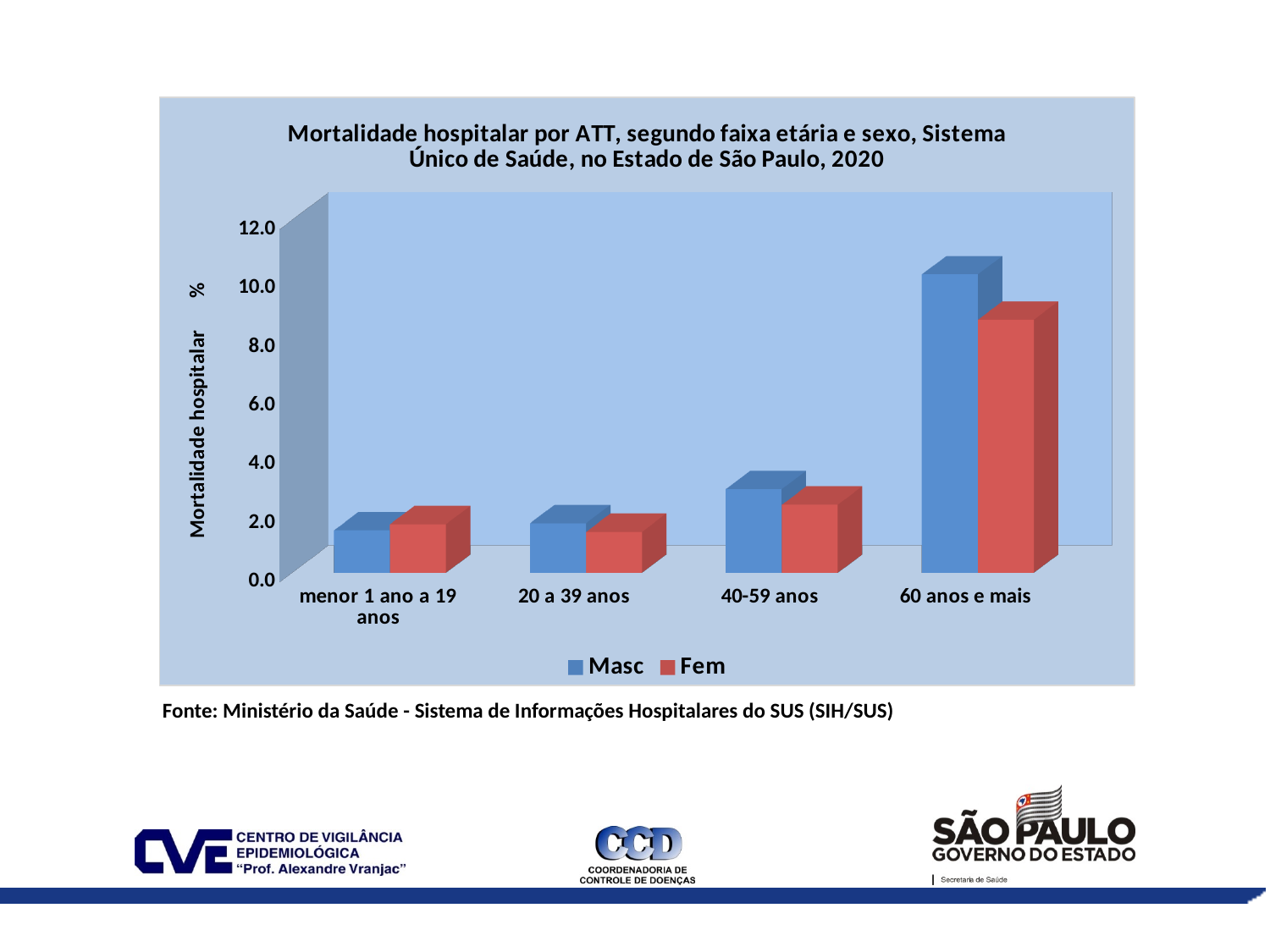
For the 60 anos e mais group, which series has the larger value, Masc or Fem? Masc Is the Fem value for 60 anos e mais greater or less than 6.0? greater Do the Masc values rise or fall as the age groups move from left to right along the x axis? rise Which age group has the highest hospital mortality for the Fem series? 60 anos e mais Which colour represents the Fem series in the legend? red Is the Masc value for 40-59 anos greater or less than 4.0? less What kind of chart is shown on the slide? bar chart How many series does the legend list? 2 How many age-group categories are shown on the x axis? 4 Is the Masc value for 60 anos e mais greater or less than 8.0? greater What is the label of the vertical axis? Mortalidade hospitalar % Which age group has the highest hospital mortality for the Masc series? 60 anos e mais